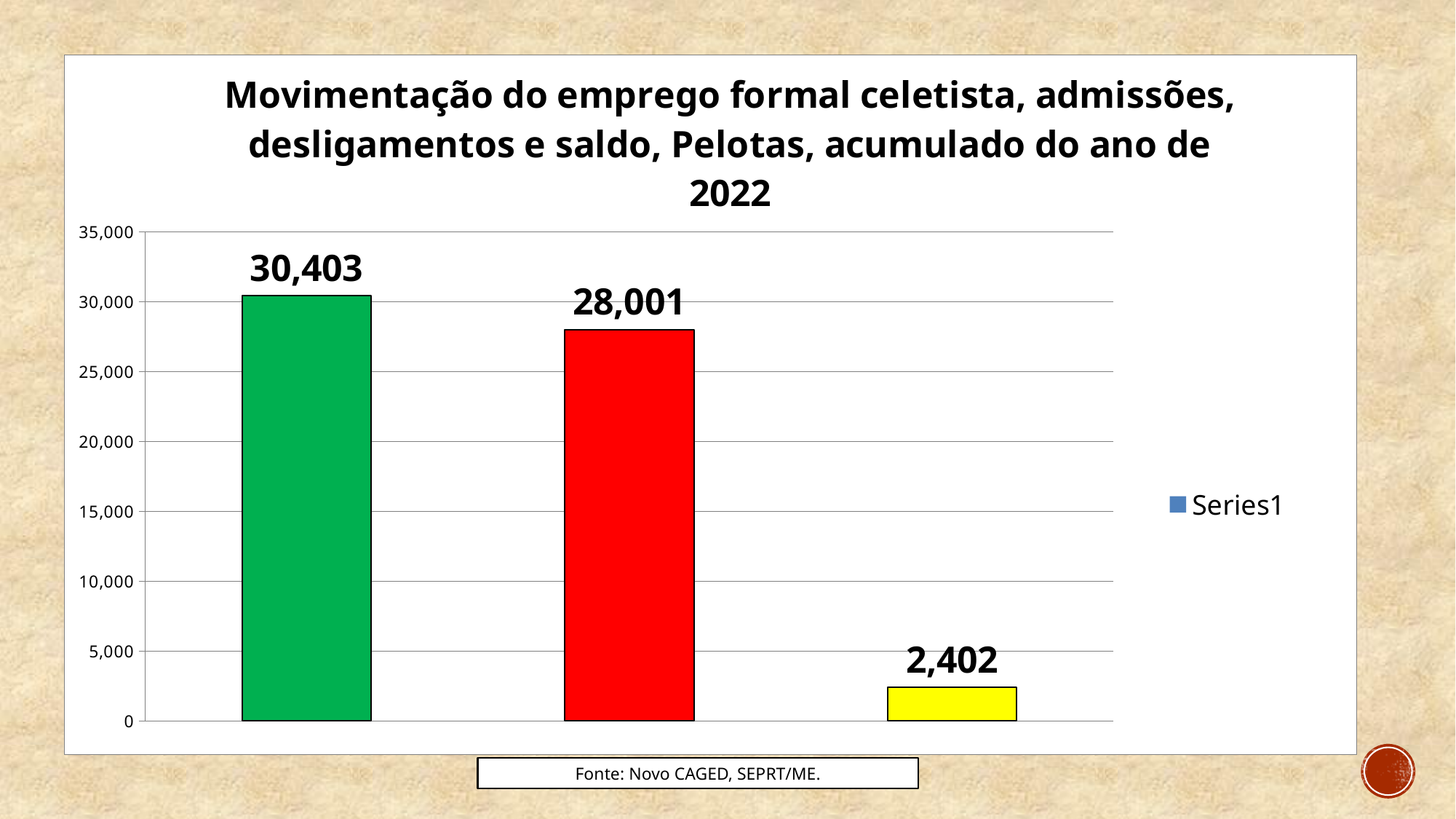
Is the value of the yellow bar greater or less than 5,000? less What is the value shown on the yellow bar (the rightmost bar)? 2,402 Which bar has the lowest value? The yellow bar (rightmost), 2,402 Which is larger, the value of the green bar or the value of the red bar? The green bar (30,403) What type of chart is shown on the slide? Bar chart How many series does the legend list? 1 What is the value shown on the red bar (the middle bar)? 28,001 What is the difference between the red bar's value and the yellow bar's value? 25,599 What is the difference between the green bar's value and the red bar's value? 2,402 Which bar has the highest value? The green bar (first from the left), 30,403 How many bars are plotted in the chart? 3 What is the value shown on the green bar (the first bar from the left)? 30,403